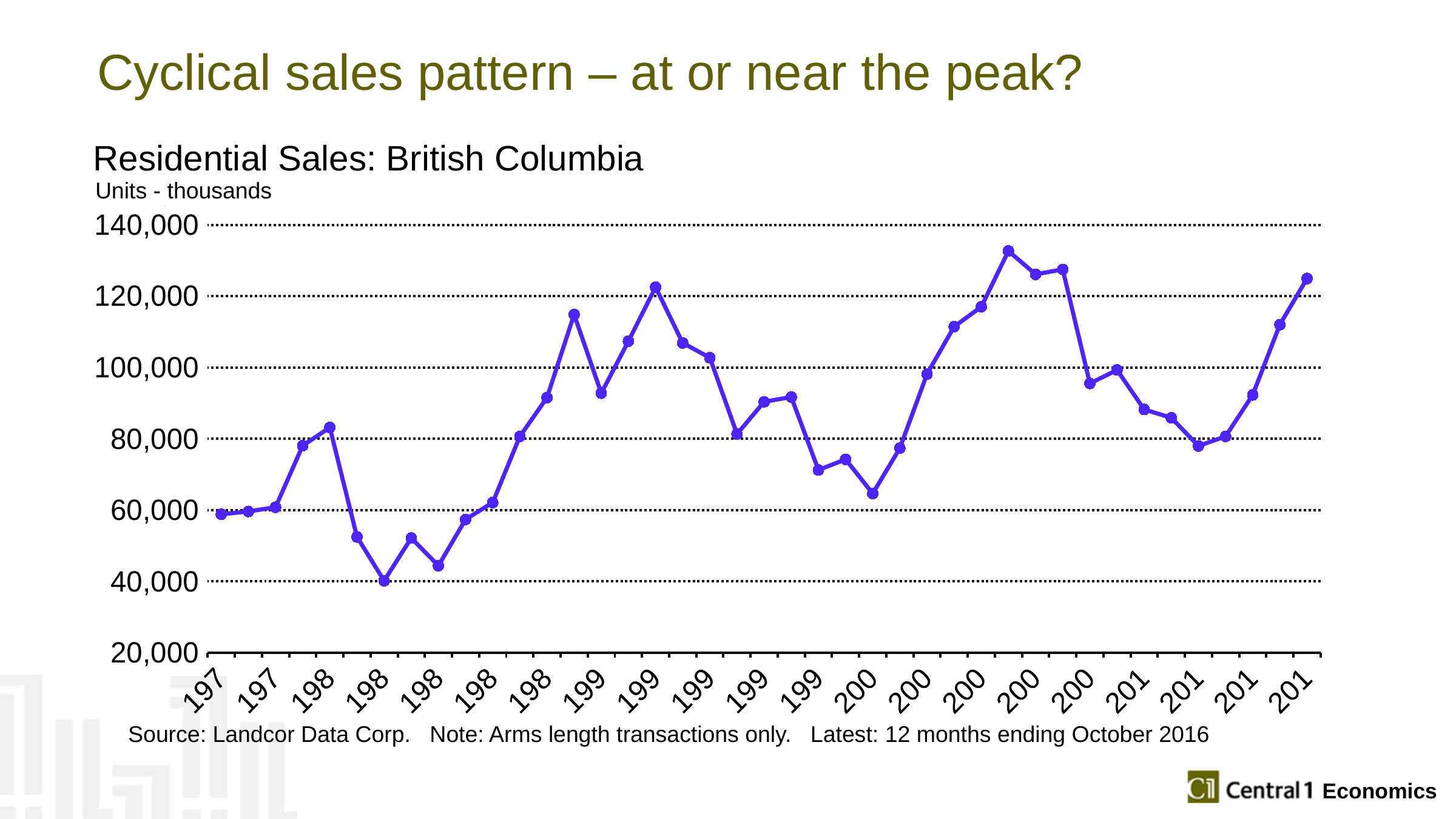
Does the line end higher or lower than where it starts? higher Is the first (leftmost) point on the line greater or less than 80,000? less What unit label is shown under the chart title? Units - thousands What kind of chart is shown on the slide? Line chart What is the highest value shown on the y axis? 140,000 Is the lowest point on the line greater or less than 60,000? less What is the title of the chart? Residential Sales: British Columbia Is the last (rightmost) point on the line greater or less than 120,000? greater How many lines (series) are plotted on the chart? 1 Is the highest peak of the line higher or lower than the final point on the right? higher